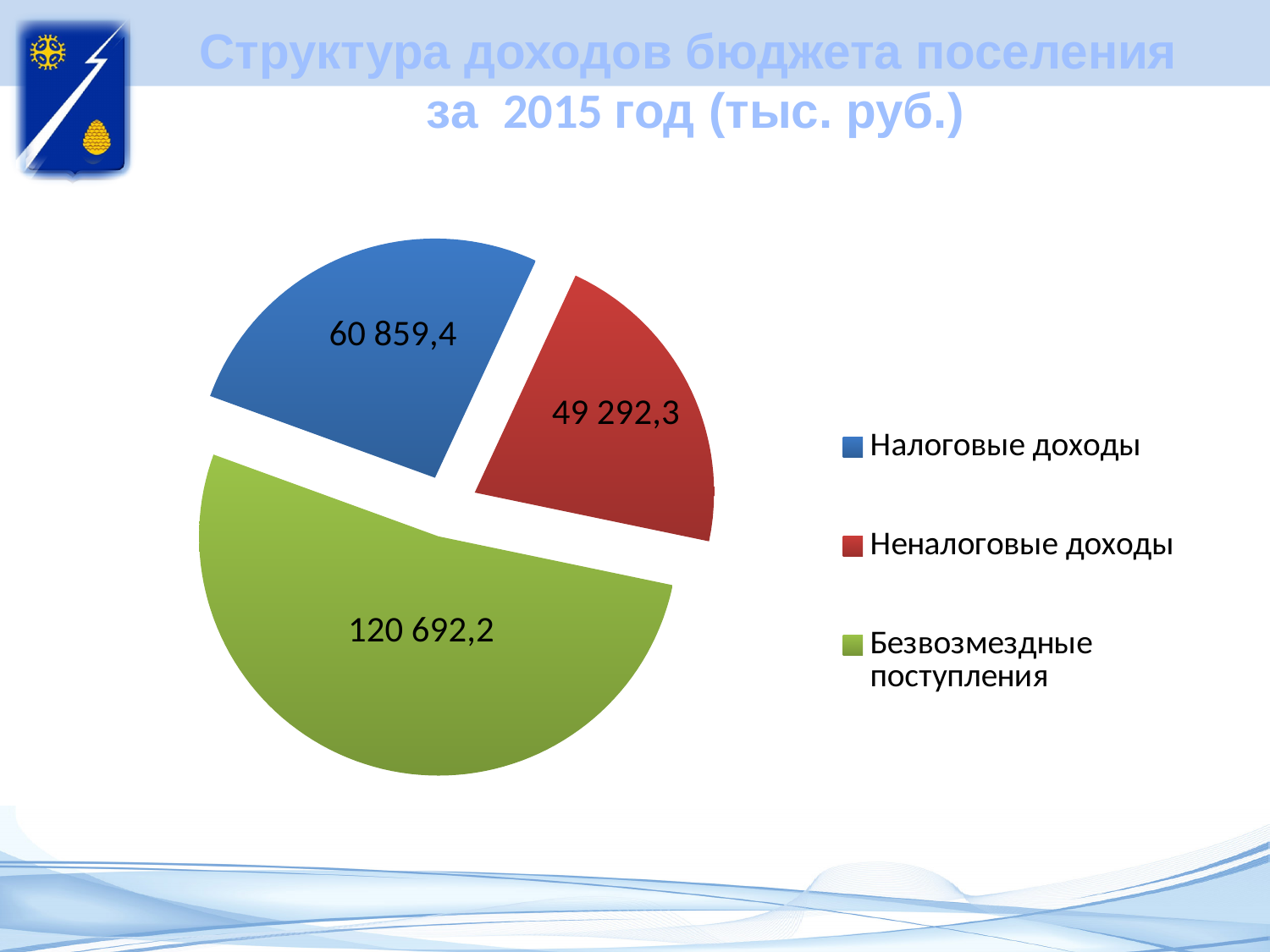
How many slices does the pie chart have? 3 What is the difference between Безвозмездные поступления and Налоговые доходы? 59 832,8 What is the total of all three slices? 230 843,9 What type of chart is shown on the slide? pie chart What is the value for Безвозмездные поступления? 120 692,2 What is the value for Неналоговые доходы? 49 292,3 Which category has the smallest slice of the pie? Неналоговые доходы Which category has the largest slice of the pie? Безвозмездные поступления What is the difference between Налоговые доходы and Неналоговые доходы? 11 567,1 Which is larger, Налоговые доходы or Неналоговые доходы? Налоговые доходы What is the value for Налоговые доходы? 60 859,4 What colour is the slice for Безвозмездные поступления? green